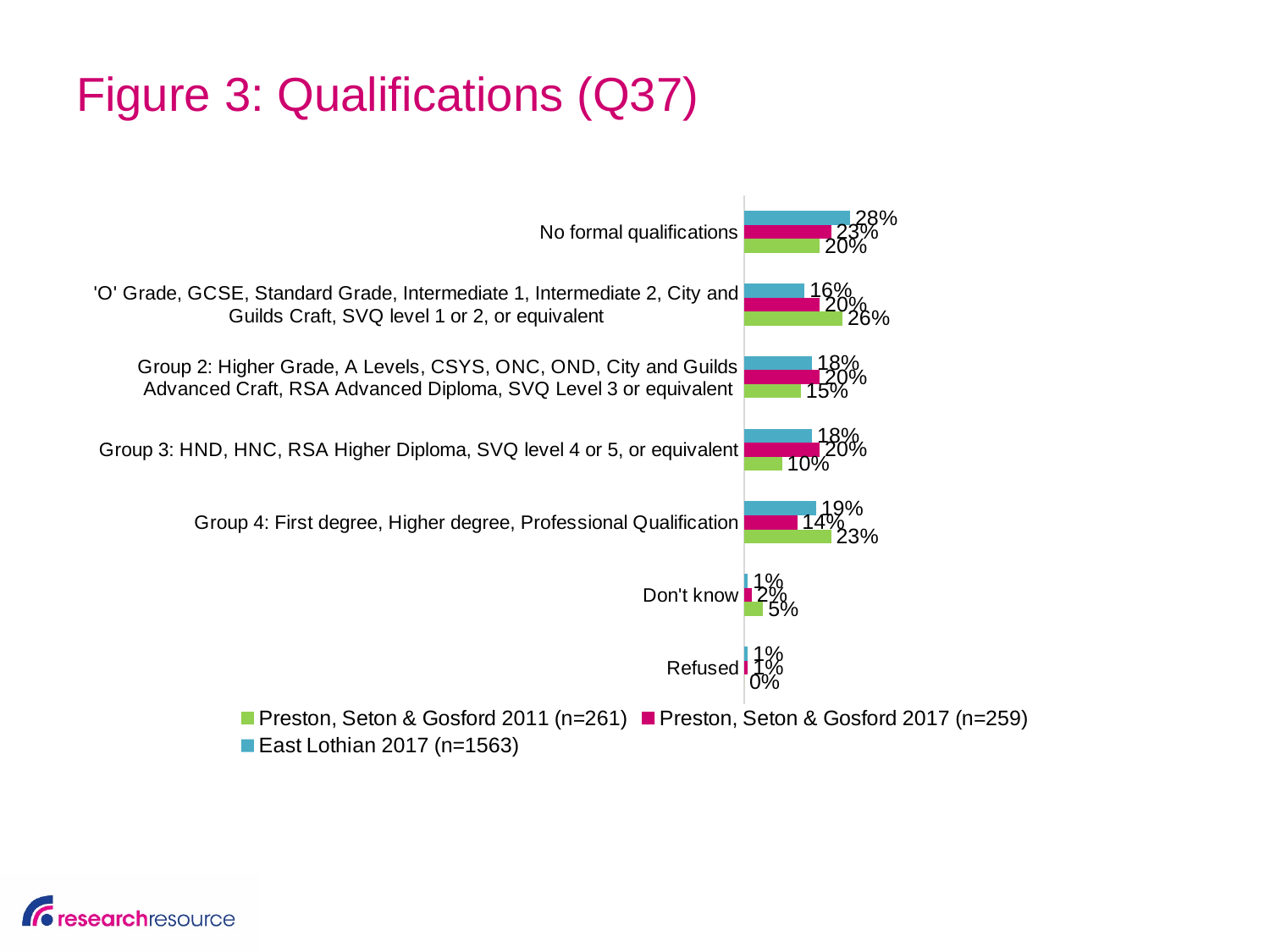
What is the difference between the Preston, Seton & Gosford 2011 (n=261) and Preston, Seton & Gosford 2017 (n=259) values for 'Group 3: HND, HNC, RSA Higher Diploma, SVQ level 4 or 5, or equivalent'? 10% How many series does the legend list? 3 What is the value for 'Don't know' for Preston, Seton & Gosford 2011 (n=261)? 5% Which category has the lowest value for Preston, Seton & Gosford 2011 (n=261)? Refused What is the value for 'Group 4: First degree, Higher degree, Professional Qualification' for Preston, Seton & Gosford 2011 (n=261)? 23% What is the value for 'Group 3: HND, HNC, RSA Higher Diploma, SVQ level 4 or 5, or equivalent' for Preston, Seton & Gosford 2017 (n=259)? 20% For 'Group 4: First degree, Higher degree, Professional Qualification', which series has the larger value: East Lothian 2017 (n=1563) or Preston, Seton & Gosford 2017 (n=259)? East Lothian 2017 (n=1563) Which colour represents the East Lothian 2017 (n=1563) series in the legend? blue What kind of chart is shown on the slide? bar chart What is the value for 'No formal qualifications' for East Lothian 2017 (n=1563)? 28% How many qualification categories are plotted on the chart? 7 Which category has the highest value for East Lothian 2017 (n=1563)? No formal qualifications